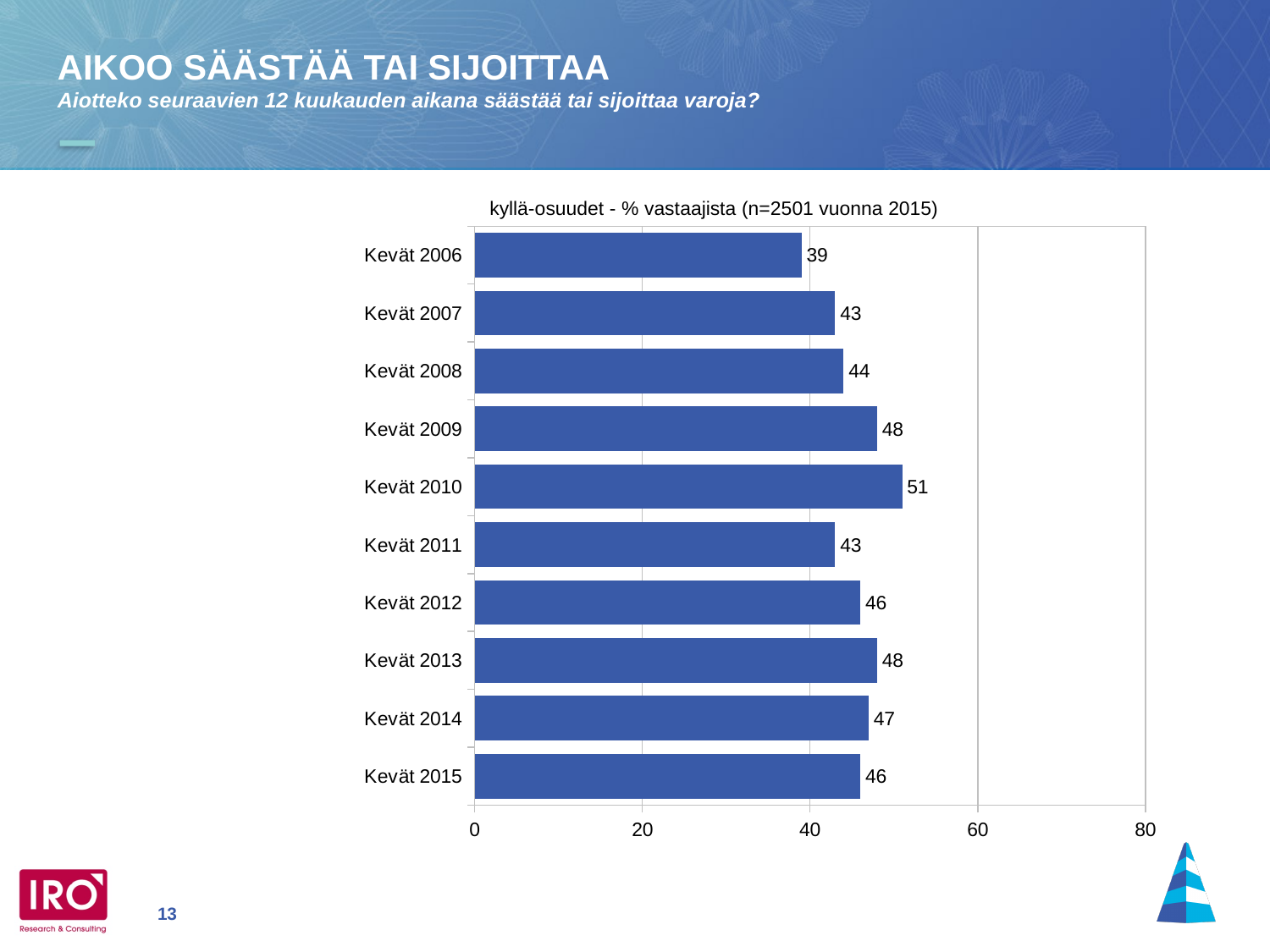
What is the difference between the values for Kevät 2010 and Kevät 2006? 12 Which category has the lowest value? Kevät 2006 Which category has the highest value? Kevät 2010 What is the value for Kevät 2015? 46 What is the value for Kevät 2010? 51 Is the value for Kevät 2010 greater or less than 40? greater What is the value for Kevät 2006? 39 How many categories are shown in the chart? 10 What is the title of the chart? kyllä-osuudet - % vastaajista (n=2501 vuonna 2015) What is the difference between the values for Kevät 2014 and Kevät 2015? 1 Which is larger, the value for Kevät 2009 or the value for Kevät 2011? Kevät 2009 What kind of chart is shown on the slide? bar chart